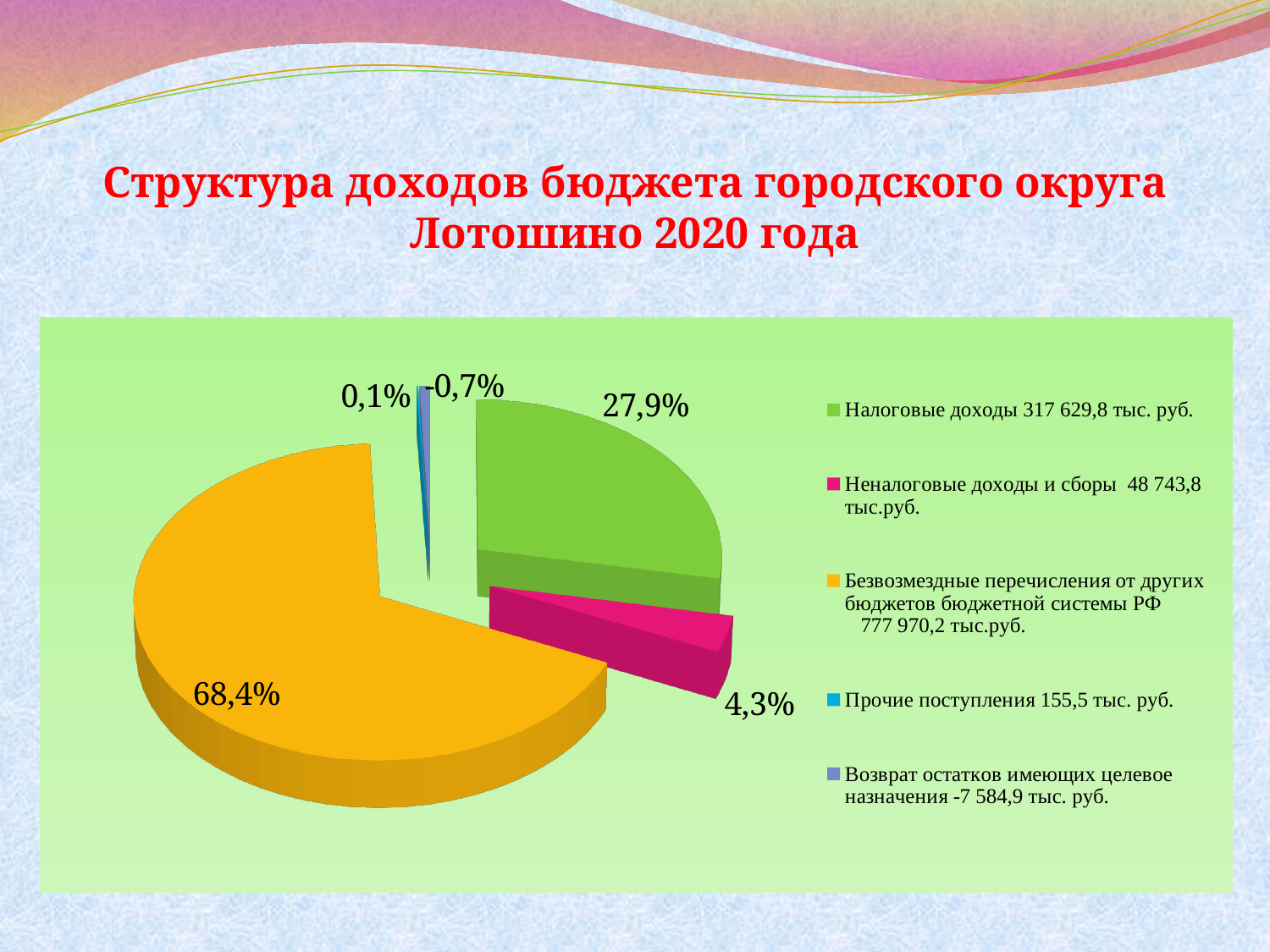
What share of the pie does the slice for Налоговые доходы have? 27,9% Which category has the smallest labelled value on the pie? Возврат остатков имеющих целевое назначения How many entries does the legend list? 5 Which category has the largest slice of the pie? Безвозмездные перечисления от других бюджетов бюджетной системы РФ What kind of chart is shown on the slide? pie chart What is the difference in percentage points between the Безвозмездные перечисления slice and the Налоговые доходы slice? 40,5 Which slice is larger: Налоговые доходы or Неналоговые доходы и сборы? Налоговые доходы What share of the pie does the slice for Безвозмездные перечисления от других бюджетов бюджетной системы РФ have? 68,4% What amount is given in the legend for Налоговые доходы? 317 629,8 тыс. руб. What share of the pie does the slice for Неналоговые доходы и сборы have? 4,3% What share of the pie does the slice for Прочие поступления have? 0,1% What value is labelled on the slice for Возврат остатков имеющих целевое назначения? -0,7%